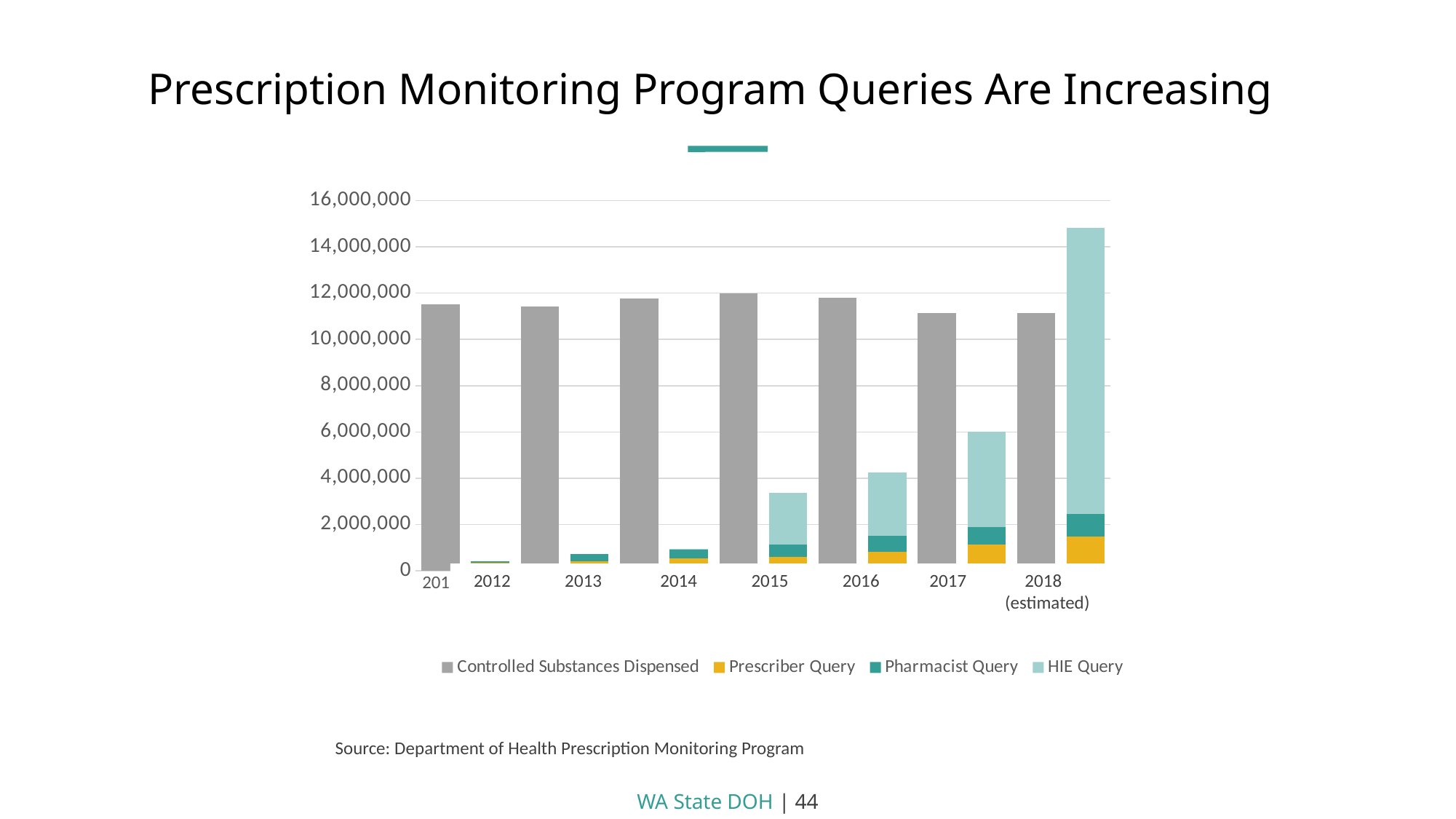
How many series does the legend list? 4 In 2018 (estimated), which is taller: the Controlled Substances Dispensed bar or the stacked query bar? the stacked query bar Is the value for Controlled Substances Dispensed in 2013 greater or less than 12,000,000? less What kind of chart is shown on the slide? Stacked bar chart Is the total of the stacked query bar for 2018 (estimated) greater or less than 14,000,000? greater Which series is shown in gray? Controlled Substances Dispensed Is the total of the stacked query bar for 2016 greater or less than 2,000,000? greater Do the stacked query bars rise or fall from 2012 to 2018 (estimated)? rise Which year has the tallest stacked query bar? 2018 (estimated) What is the title of the chart? Prescription Monitoring Program Queries Are Increasing